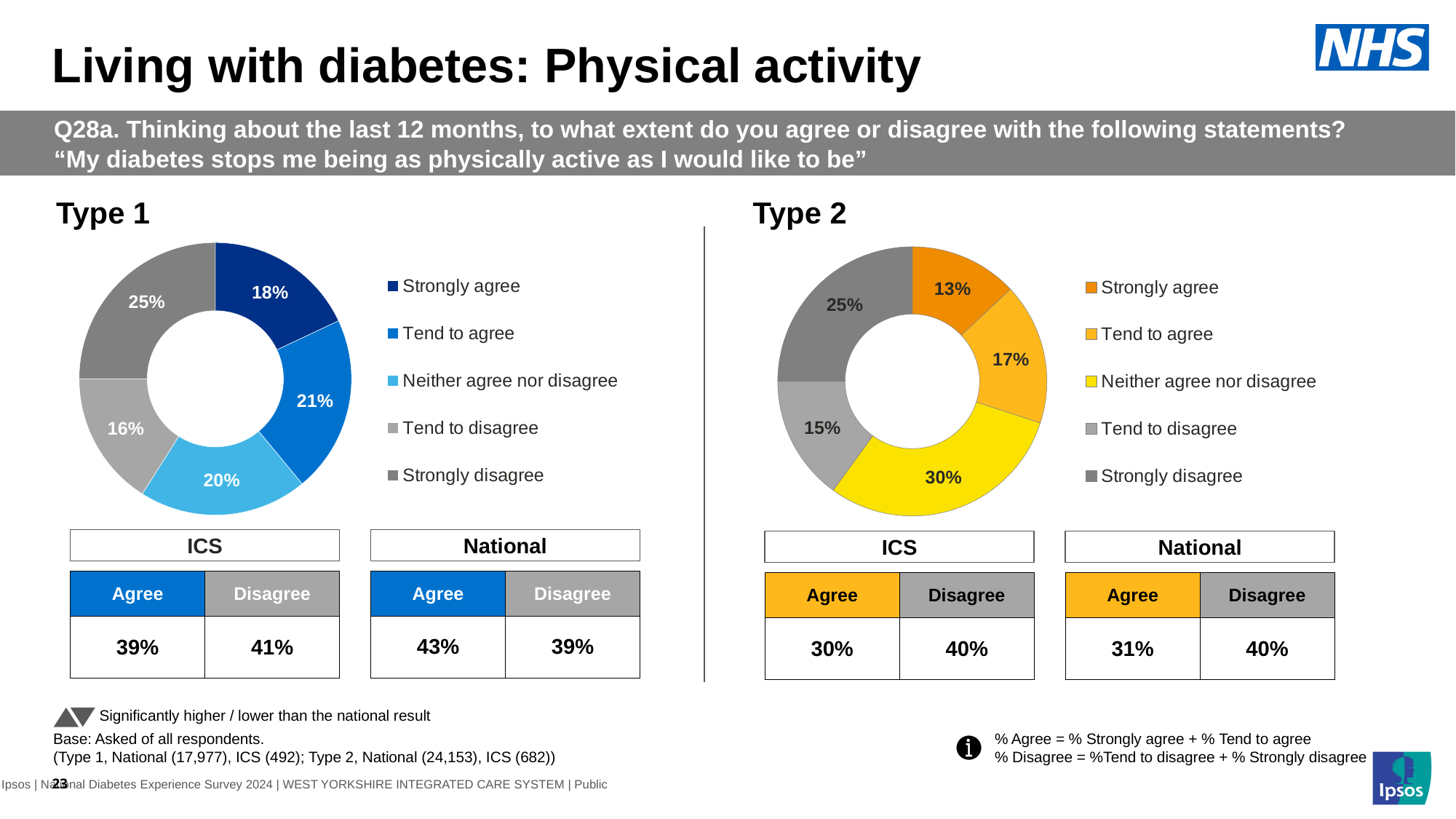
In the Type 2 chart, which response category has the smallest share? Strongly agree In the Type 1 chart, which response category has the smallest share? Tend to disagree In the Type 1 chart, what percentage of respondents said 'Strongly agree'? 18% In the Type 2 chart, what percentage of respondents said 'Neither agree nor disagree'? 30% In the Type 1 chart, which response category has the largest share? Strongly disagree In the Type 2 chart, which is larger: 'Tend to agree' or 'Strongly disagree'? Strongly disagree What kind of chart is used for the Type 1 results? Donut chart In the Type 1 chart, what is the difference between the 'Tend to agree' and 'Tend to disagree' shares? 5% In the Type 1 chart, what colour is the 'Neither agree nor disagree' segment? Light blue How many response categories does the Type 2 chart show? 5 In the Type 2 chart, which response category has the largest share? Neither agree nor disagree In the Type 2 chart, what is the combined share of 'Strongly agree' and 'Tend to agree'? 30%